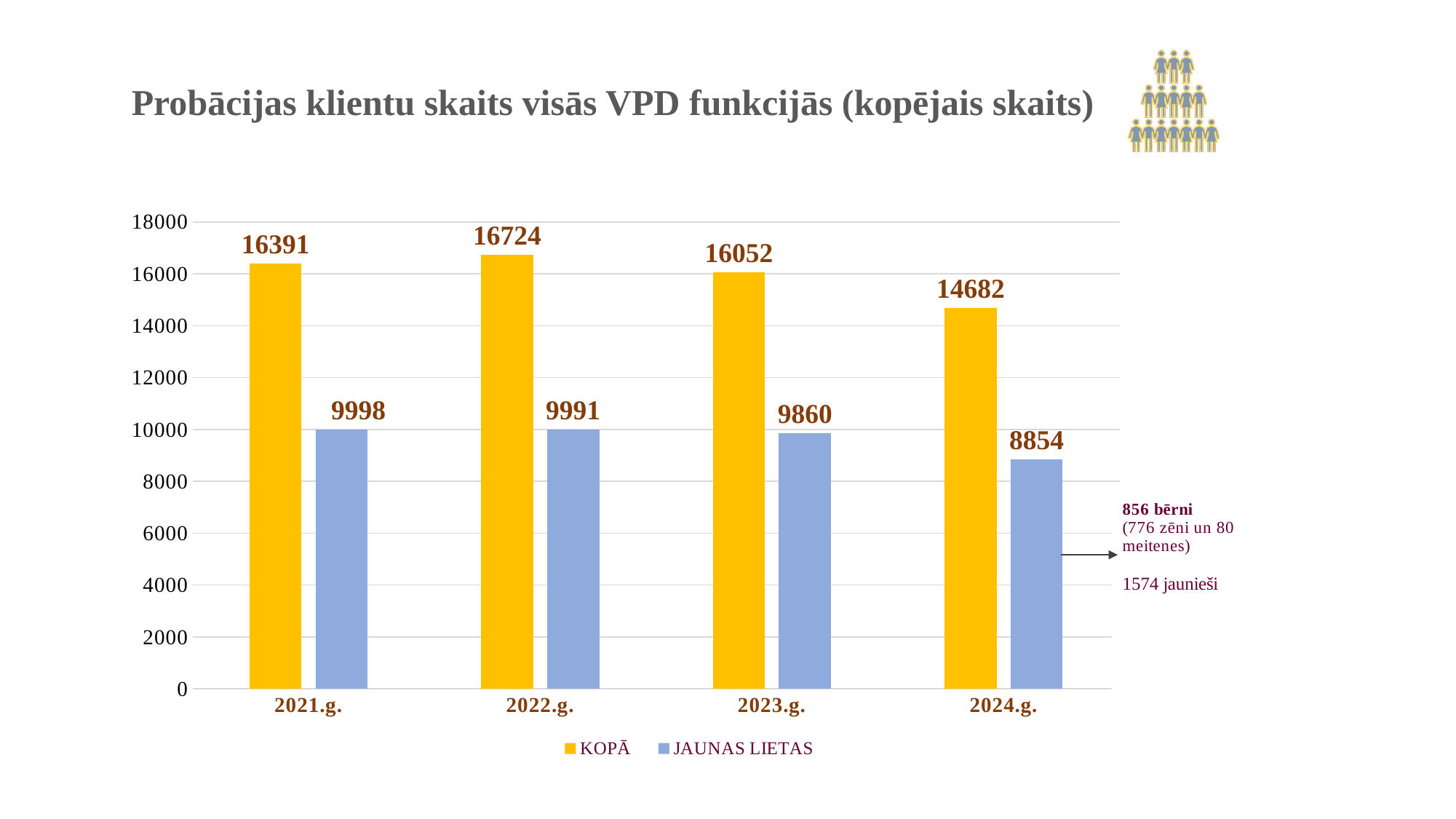
What kind of chart is shown on the slide? bar chart What is the KOPĀ value for 2022.g.? 16724 What is the JAUNAS LIETAS value for 2021.g.? 9998 What is the JAUNAS LIETAS value for 2024.g.? 8854 How many series does the legend list? 2 What is the difference between the KOPĀ values for 2022.g. and 2024.g.? 2042 Which year has the highest KOPĀ value? 2022.g. Does the JAUNAS LIETAS series rise or fall from 2021.g. to 2024.g.? fall How many years are shown on the x axis? 4 What is the difference between the KOPĀ and JAUNAS LIETAS values for 2023.g.? 6192 Which is larger: the KOPĀ value for 2021.g. or the KOPĀ value for 2023.g.? 2021.g. Which year has the lowest JAUNAS LIETAS value? 2024.g.